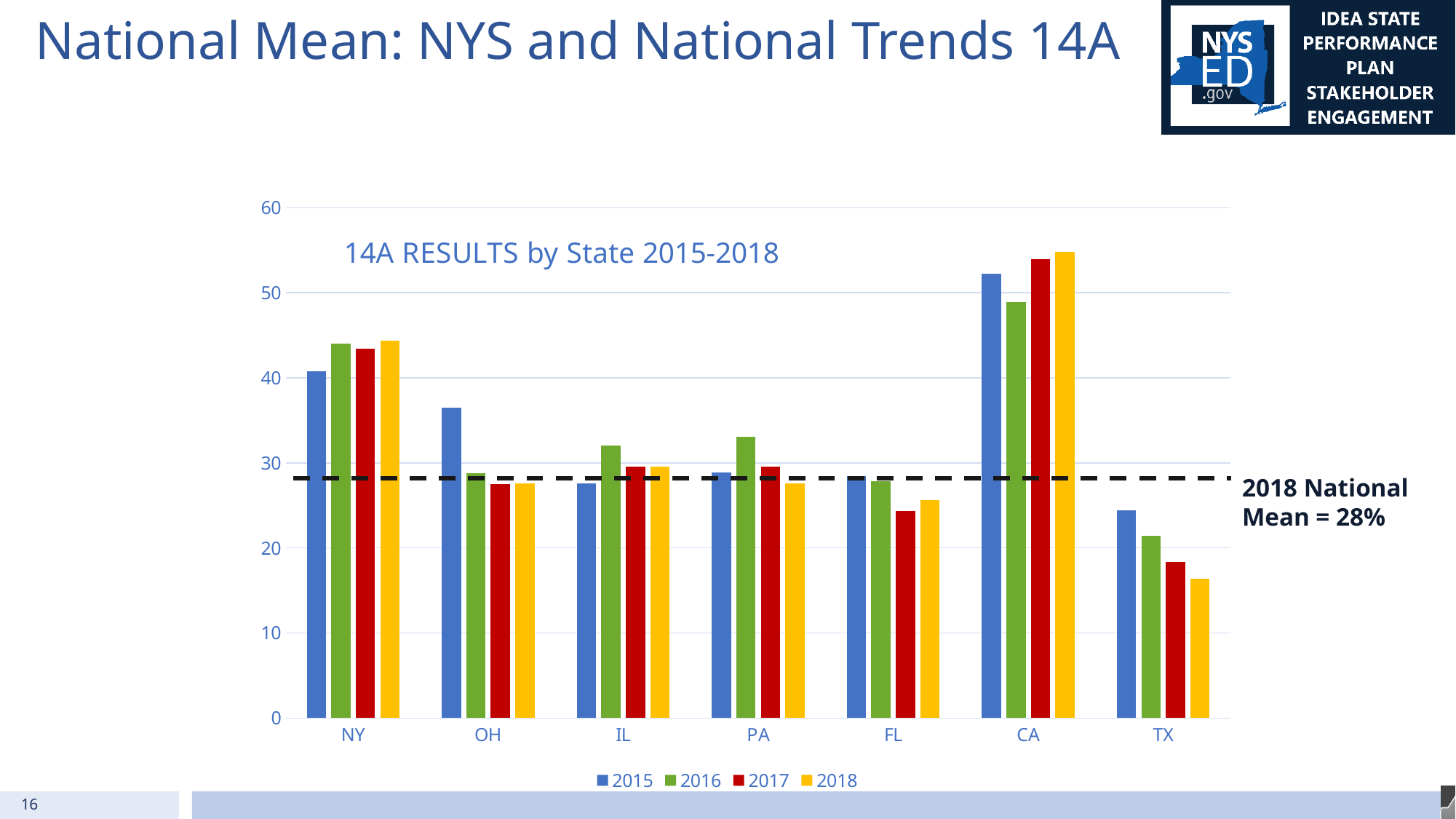
Do the values for TX rise or fall from 2015 to 2018? fall How many states are shown on the x axis? 7 Which is larger, the 2018 value for NY or the 2018 value for OH? NY What kind of chart is shown on the slide? Bar chart Which state has the highest 2018 value? CA What is the 2018 National Mean shown by the dashed line? 28% Is the 2018 value for TX greater or less than 20? less Is the 2015 value for OH greater or less than 30? greater How many series does the legend list? 4 Which state has the lowest 2018 value? TX Which is larger for CA, the 2015 value or the 2016 value? 2015 Is the 2018 value for CA greater or less than 50? greater